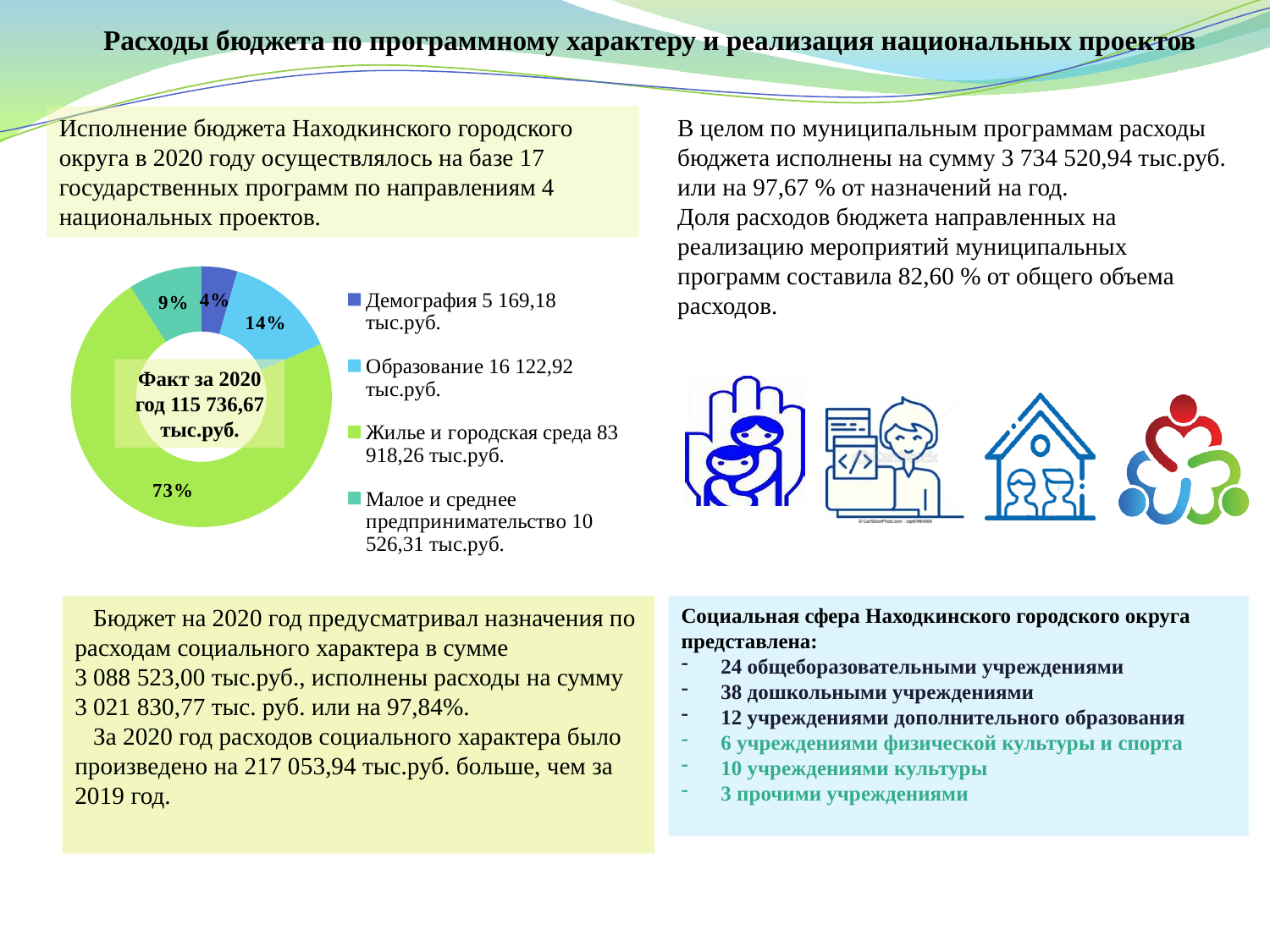
What percentage share does the slice for Образование have? 14% What value in тыс.руб. does the legend give for Образование? 16 122,92 тыс.руб. Which has a larger share: Образование or Малое и среднее предпринимательство? Образование Which category has the largest share of the doughnut chart? Жилье и городская среда What percentage share does the slice for Демография have? 4% What is the difference in percentage points between the shares of Жилье и городская среда and Образование? 59 What total amount is printed in the centre of the doughnut chart? Факт за 2020 год 115 736,67 тыс.руб. What kind of chart is shown on the slide? Doughnut (pie) chart What percentage share does the slice for Малое и среднее предпринимательство have? 9% How many slices does the doughnut chart have? 4 Which category has the smallest share of the doughnut chart? Демография